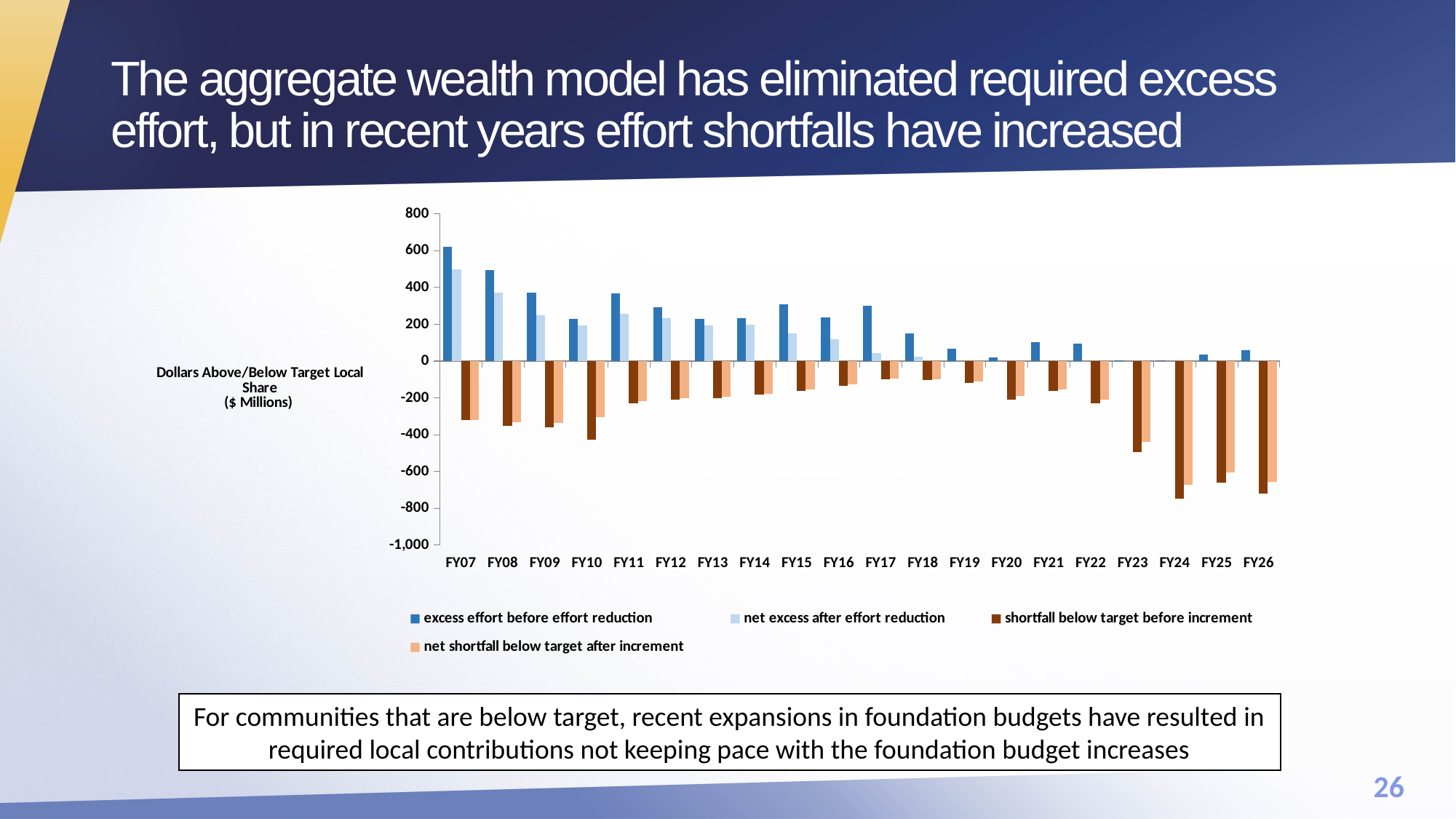
Is the value for 'excess effort before effort reduction' in FY19 greater or less than 200? less Does the 'excess effort before effort reduction' series generally rise or fall from FY07 to FY26? fall Is the value for 'shortfall below target before increment' in FY24 greater or less than -600? less How many series does the chart's legend list? 4 In which fiscal year is the value for 'excess effort before effort reduction' highest? FY07 How many fiscal years are shown along the x axis of the chart? 20 Which fiscal year has the larger (more negative) 'shortfall below target before increment', FY22 or FY23? FY23 Is the value for 'excess effort before effort reduction' in FY07 greater or less than 400? greater What kind of chart is shown on the slide? bar chart What is the label on the chart's vertical axis? Dollars Above/Below Target Local Share ($ Millions) Which is larger, the 'excess effort before effort reduction' value for FY07 or for FY08? FY07